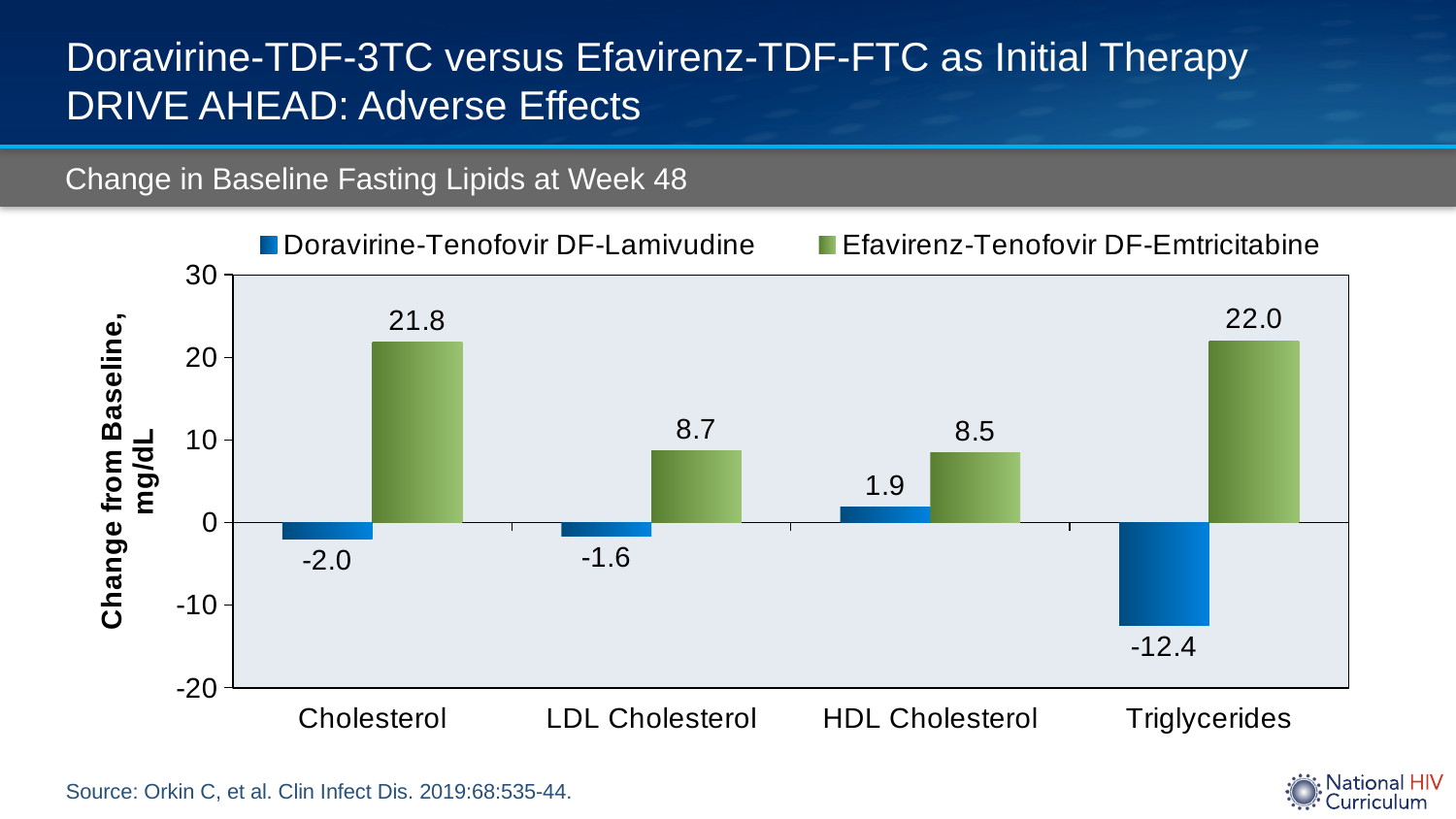
How many lipid categories are shown on the x axis? 4 What is the change from baseline in triglycerides for the Efavirenz-Tenofovir DF-Emtricitabine group? 22.0 What is the difference between the Efavirenz-Tenofovir DF-Emtricitabine and Doravirine-Tenofovir DF-Lamivudine values for triglycerides? 34.4 How many series does the legend list? 2 What is the change from baseline in cholesterol for the Doravirine-Tenofovir DF-Lamivudine group? -2.0 What is the change from baseline in HDL cholesterol for the Doravirine-Tenofovir DF-Lamivudine group? 1.9 What is the change from baseline in LDL cholesterol for the Efavirenz-Tenofovir DF-Emtricitabine group? 8.7 What is the difference between the Efavirenz-Tenofovir DF-Emtricitabine and Doravirine-Tenofovir DF-Lamivudine values for cholesterol? 23.8 Which lipid category has the lowest value for the Doravirine-Tenofovir DF-Lamivudine group? Triglycerides What kind of chart is shown on the slide? Bar chart Which lipid category has the highest value for the Efavirenz-Tenofovir DF-Emtricitabine group? Triglycerides For HDL cholesterol, which group has the larger change from baseline? Efavirenz-Tenofovir DF-Emtricitabine